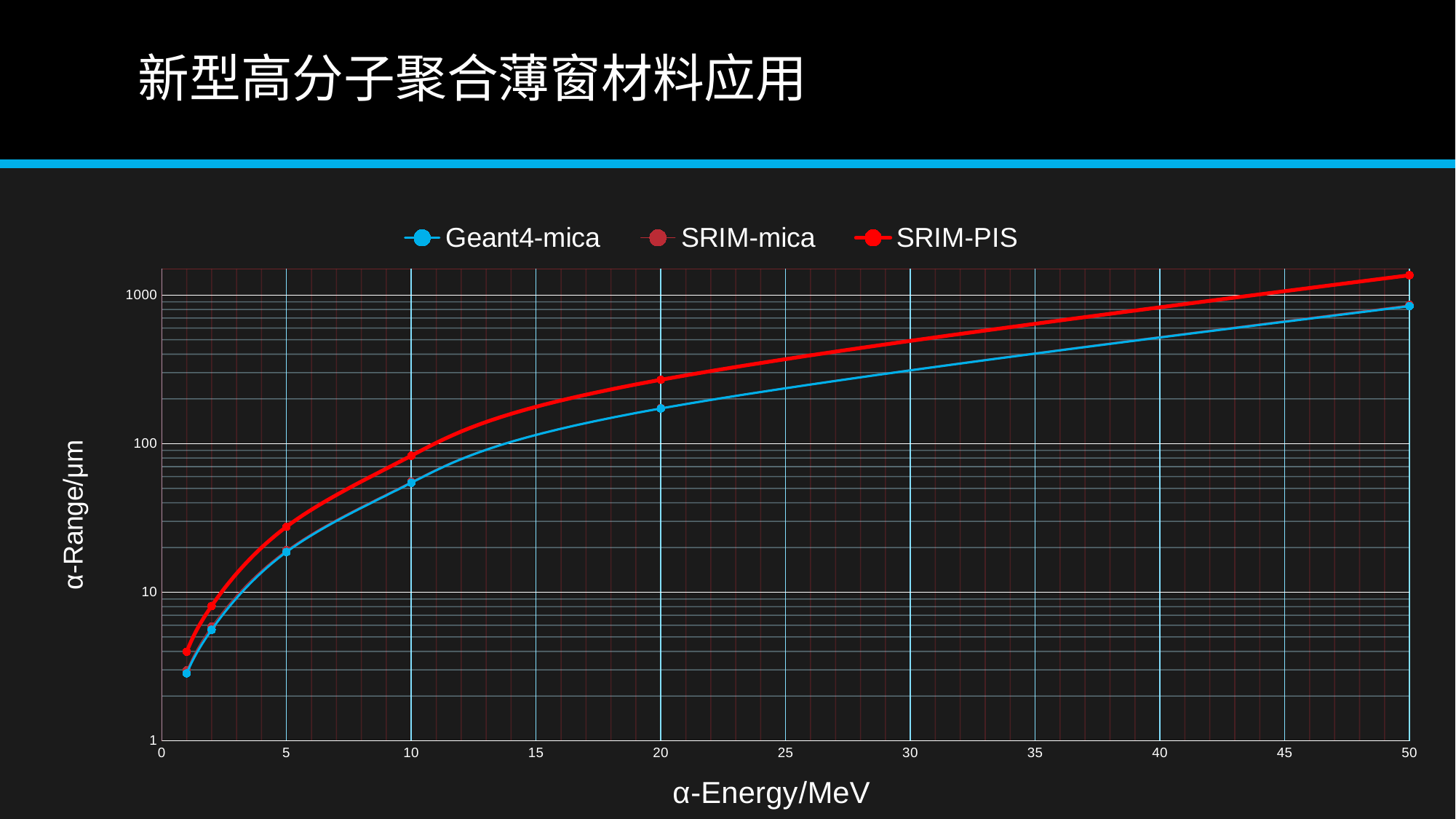
At 20 MeV, which series has the larger α-Range: SRIM-PIS or Geant4-mica? SRIM-PIS What is the title of the x axis? α-Energy/MeV Is the Geant4-mica value at 1 MeV greater or less than 10? less Do the α-Range values rise or fall as α-Energy increases along the x axis? rise How many data points are plotted for the Geant4-mica series? 6 What is the title of the y axis? α-Range/μm Is the Geant4-mica value at 50 MeV greater or less than 1000? less Is the Geant4-mica value at 10 MeV greater or less than 100? less How many series does the legend list? 3 What kind of chart is shown on the slide? line chart